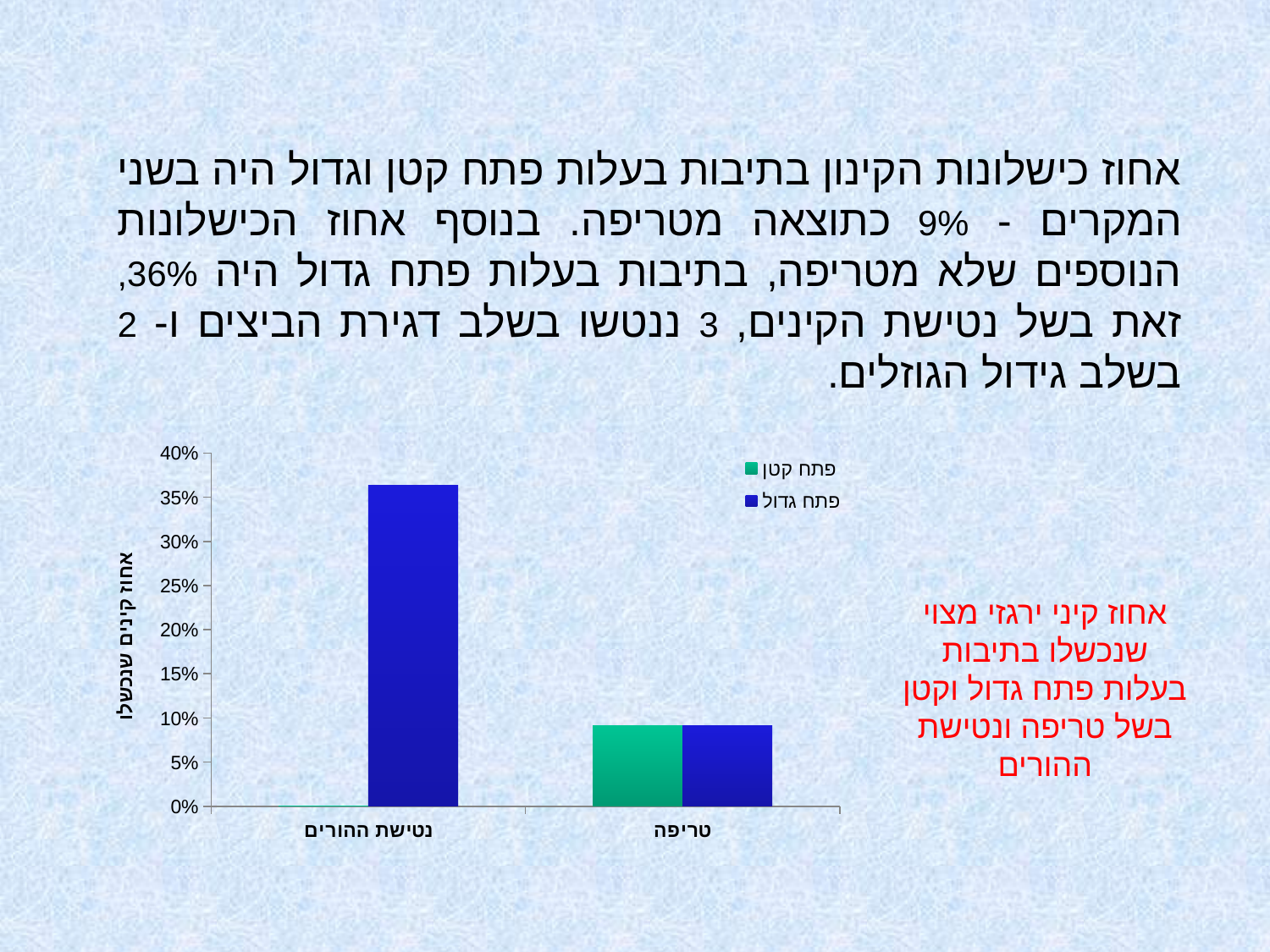
Which category has the highest value for the פתח גדול series? נטישת ההורים How many series does the chart legend list? 2 What is the title of the chart's vertical axis? אחוז קינים שנכשלו What are the two entries listed in the chart legend? פתח קטן, פתח גדול Is the value for פתח גדול in the category נטישת ההורים greater or less than 40%? less What kind of chart is shown on the slide? bar chart Is the value for פתח גדול in the category טריפה greater or less than 5%? greater How many categories are shown on the x axis of the chart? 2 For the category נטישת ההורים, which series has the larger value, פתח קטן or פתח גדול? פתח גדול Is the value for פתח גדול in the category נטישת ההורים greater or less than 30%? greater Which category has the lowest value for the פתח קטן series? נטישת ההורים